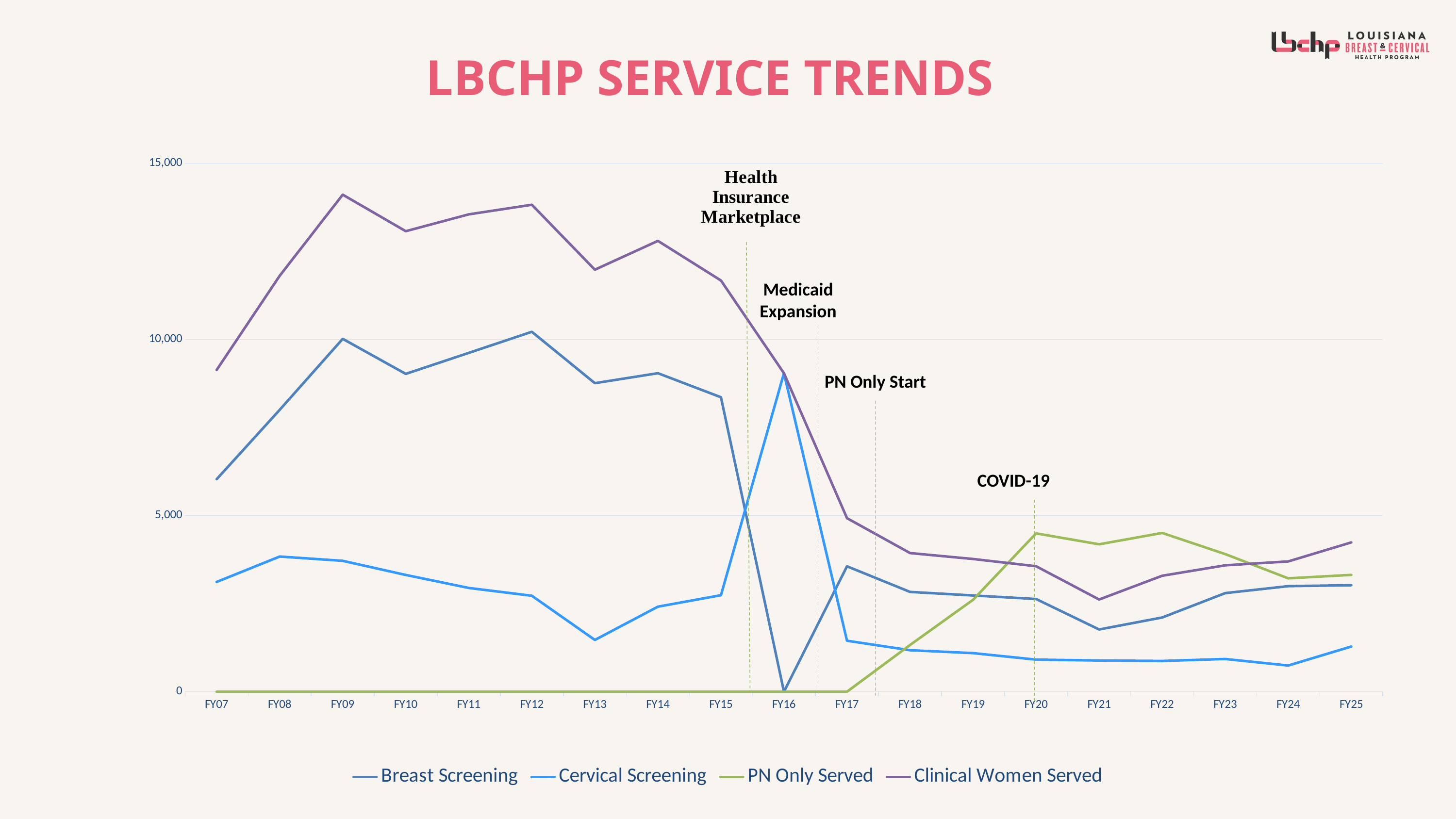
What kind of chart is shown on the slide? line chart Which event annotation is marked at FY20 on the chart? COVID-19 Is the value for Cervical Screening in FY16 greater or less than 5,000? greater Does Cervical Screening rise or fall from FY08 to FY13? fall Is the value for Breast Screening in FY07 greater or less than 5,000? greater Is the value for Clinical Women Served in FY07 greater or less than 10,000? less How many fiscal years are plotted along the x axis? 19 In FY25, which is larger: Clinical Women Served or Cervical Screening? Clinical Women Served In which fiscal year does Breast Screening reach its lowest value? FY16 In which fiscal year does Clinical Women Served reach its highest value? FY09 In which fiscal year does Cervical Screening reach its highest value? FY16 How many series does the legend list? 4